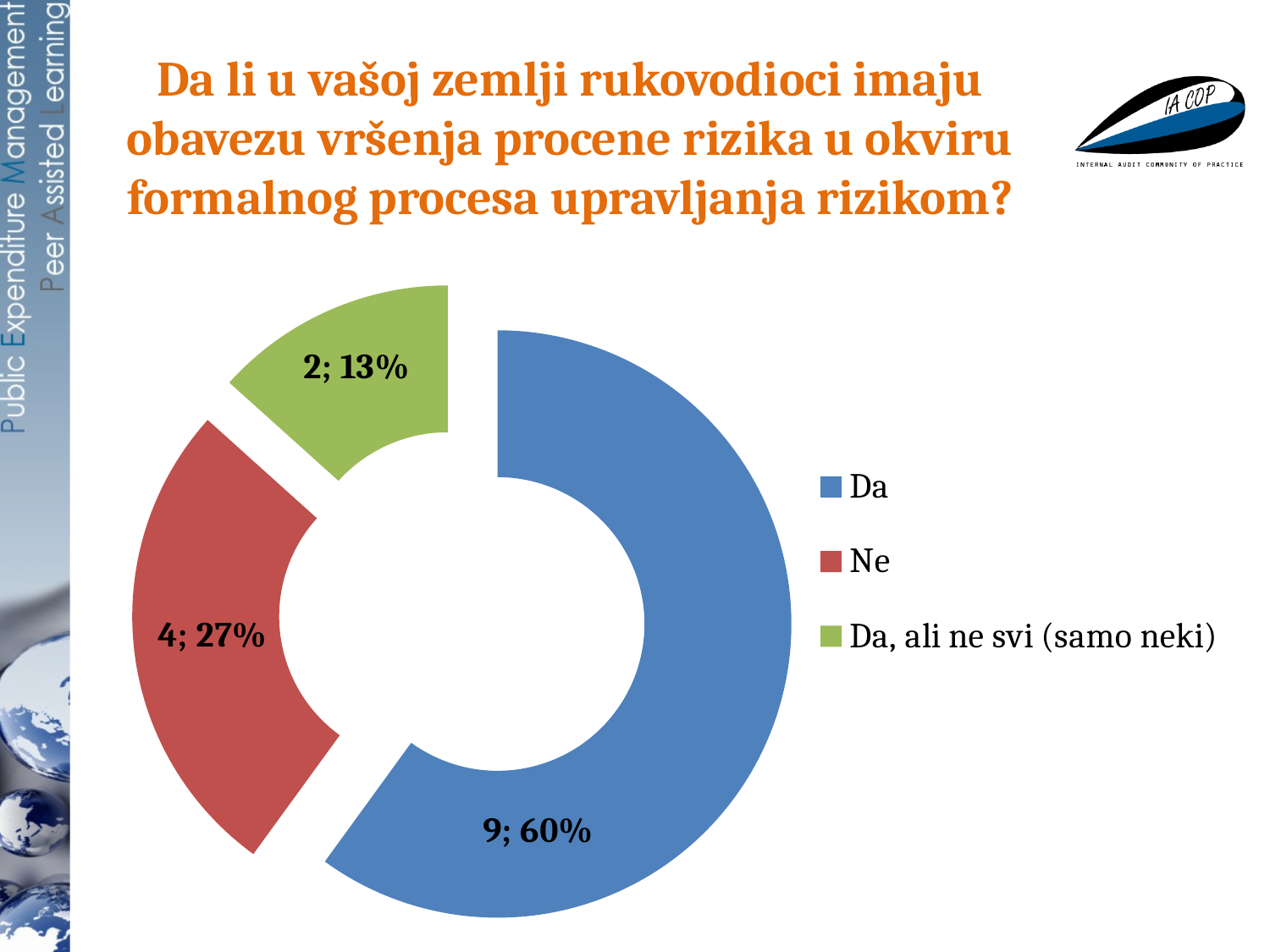
What is the difference in count between 'Da' and 'Ne'? 5 How many categories does the legend list? 3 What colour represents the 'Ne' category? Red What is the total count across all three categories? 15 What percentage share does the 'Ne' category have? 27% Which has a larger count, 'Ne' or 'Da, ali ne svi (samo neki)'? Ne What percentage share does the 'Da' category have? 60% Which category has the largest share? Da What is the count for the 'Da' category? 9 What is the count for 'Da, ali ne svi (samo neki)'? 2 What kind of chart is shown on the slide? Doughnut (pie) chart Which category has the smallest share? Da, ali ne svi (samo neki)